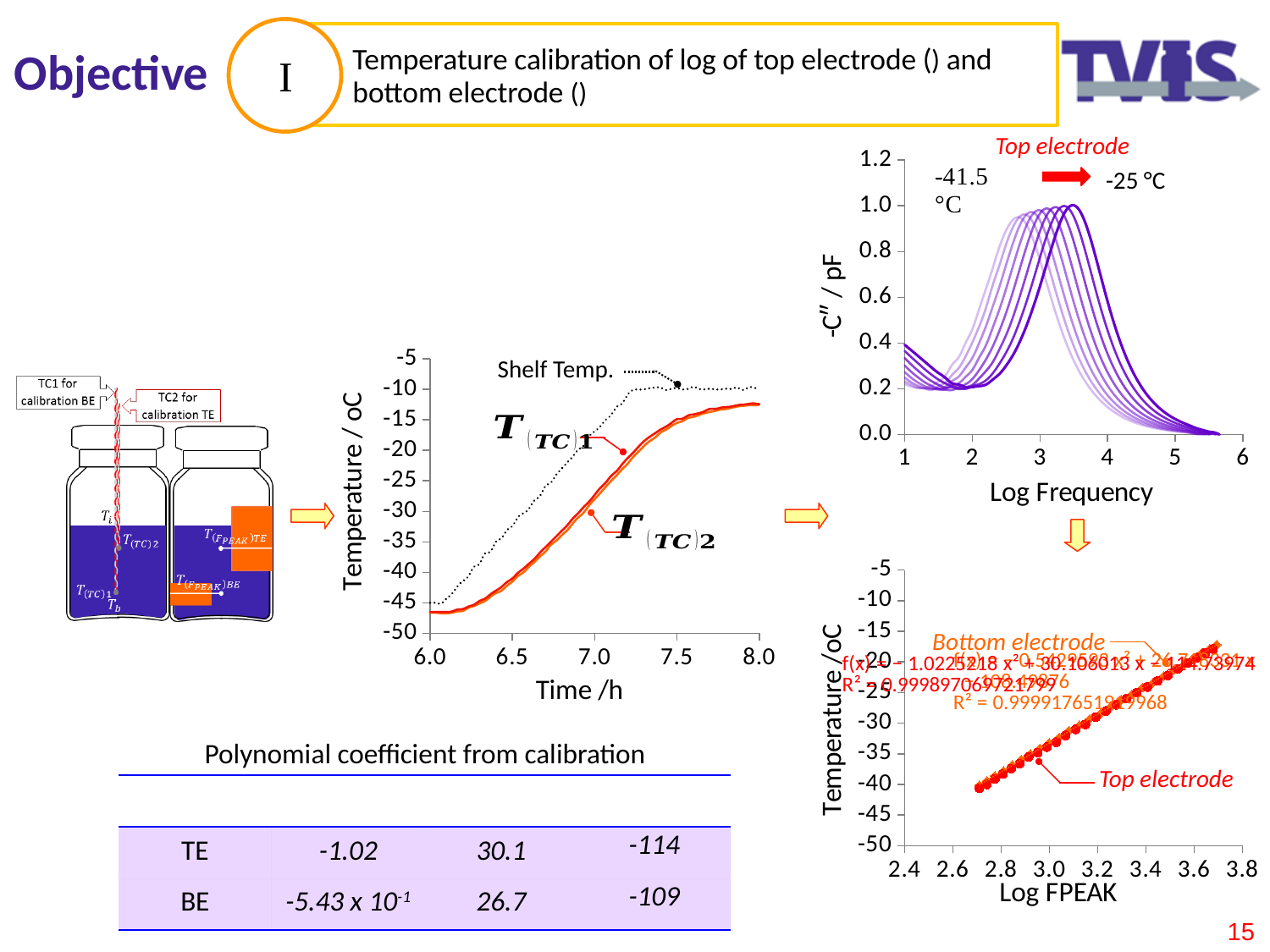
In the bottom-right chart of Temperature against Log FPEAK, is the temperature at Log FPEAK 2.7 greater or less than -35? less In the middle chart of Temperature against Time, do the T(TC)1 and T(TC)2 curves rise or fall as time increases from 6.0 h to 8.0 h? rise In the top-right chart of -C'' against Log Frequency, is the peak value of the curves greater or less than 0.8? greater In the middle chart of Temperature against Time, is the Shelf Temp. value at 7.5 h greater or less than -15? greater In the middle chart of Temperature against Time, what is the label of the x axis? Time /h In the top-right chart of -C'' against Log Frequency, what is the highest value shown on the y axis? 1.2 What kind of chart is the bottom-right chart of Temperature against Log FPEAK? scatter chart In the bottom-right chart of Temperature against Log FPEAK, does temperature rise or fall as Log FPEAK increases? rise In the middle chart of Temperature against Time, which series has the highest temperature at 7.0 h: Shelf Temp. or T(TC)2? Shelf Temp. What kind of chart is the middle chart of Temperature against Time? line chart